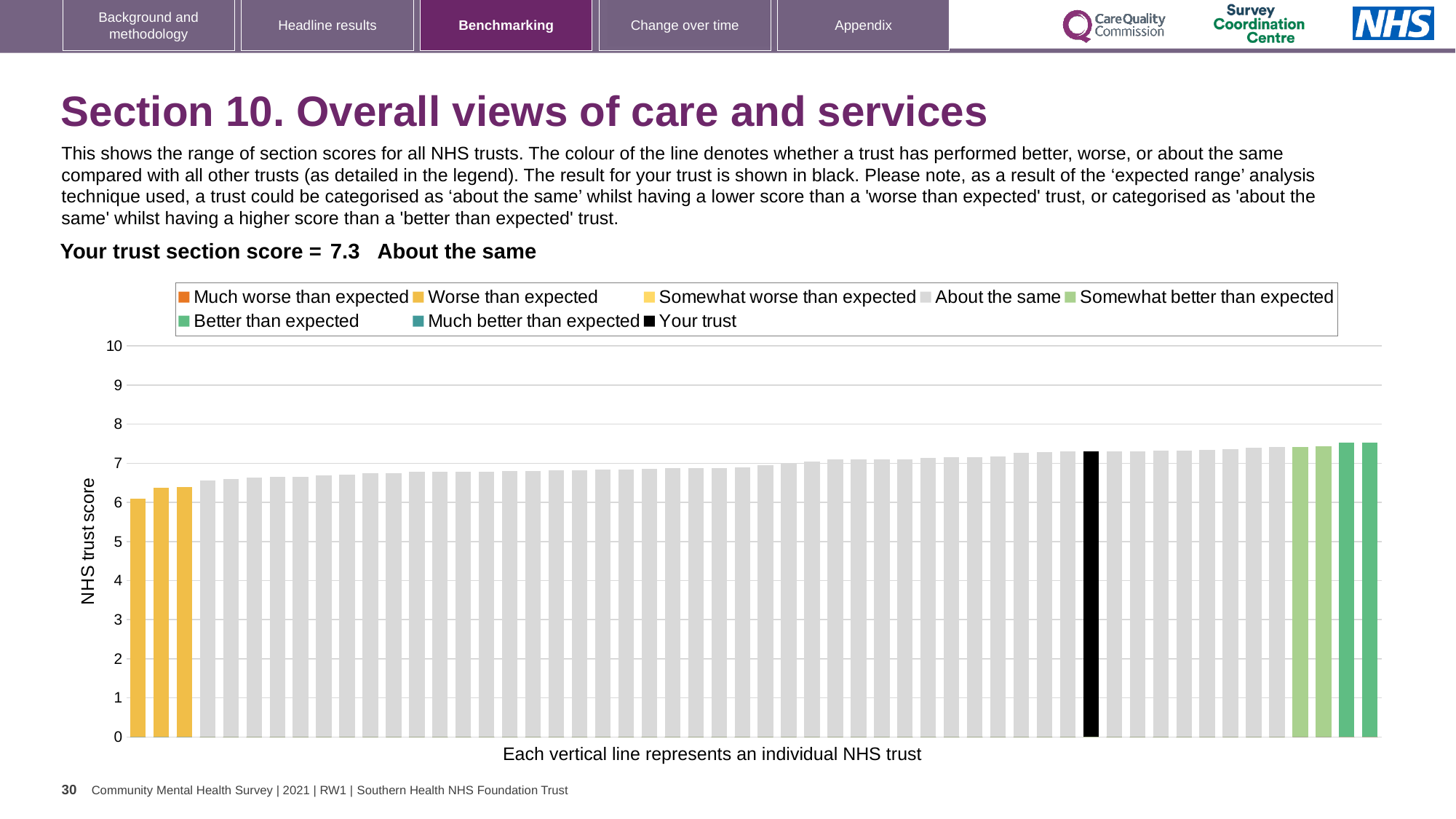
Do the bar values rise or fall from left to right along the x axis? Rise What colour is used for the 'Your trust' bar in the chart? Black Which category is your trust's section score placed in? About the same What is the label on the vertical axis of the chart? NHS trust score Is the value of the black bar (your trust) greater or less than 7? greater Is the value of the leftmost bar greater or less than 7? less How many bars are coloured in the 'Better than expected' green colour? 2 How many entries does the chart legend list? 8 How many bars are coloured in the 'Worse than expected' yellow colour? 3 Is the value of the tallest bar greater or less than 8? less What kind of chart is shown on the slide? Bar chart What is the section score for your trust shown on the slide? 7.3